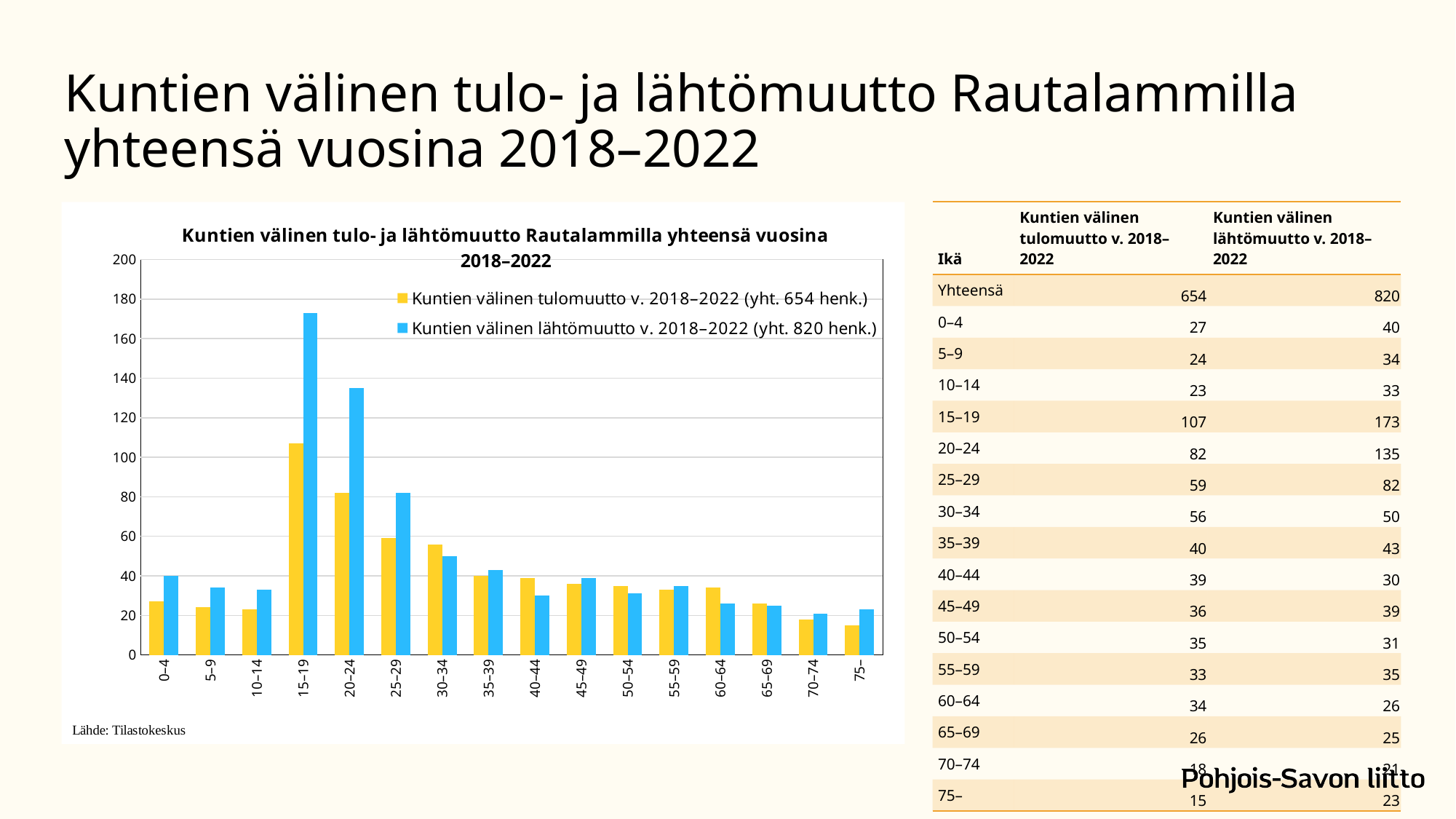
How many age groups are shown on the x axis of the chart? 16 Is the value of Kuntien välinen lähtömuutto for the 15–19 age group greater or less than 160? greater According to the legend, what is the total number of persons for Kuntien välinen tulomuutto v. 2018–2022? 654 henk. How many series does the chart's legend list? 2 Which age group has the lowest value for Kuntien välinen tulomuutto v. 2018–2022? 75– Which age group has the highest value for Kuntien välinen tulomuutto v. 2018–2022? 15–19 For the 30–34 age group, which is larger: tulomuutto or lähtömuutto? tulomuutto Which age group has the highest value for Kuntien välinen lähtömuutto v. 2018–2022? 15–19 What is the value of Kuntien välinen lähtömuutto v. 2018–2022 for the 20–24 age group? 135 What kind of chart is shown on the slide? bar chart For the 15–19 age group, what is the difference between lähtömuutto and tulomuutto? 66 What is the value of Kuntien välinen tulomuutto v. 2018–2022 for the 15–19 age group? 107